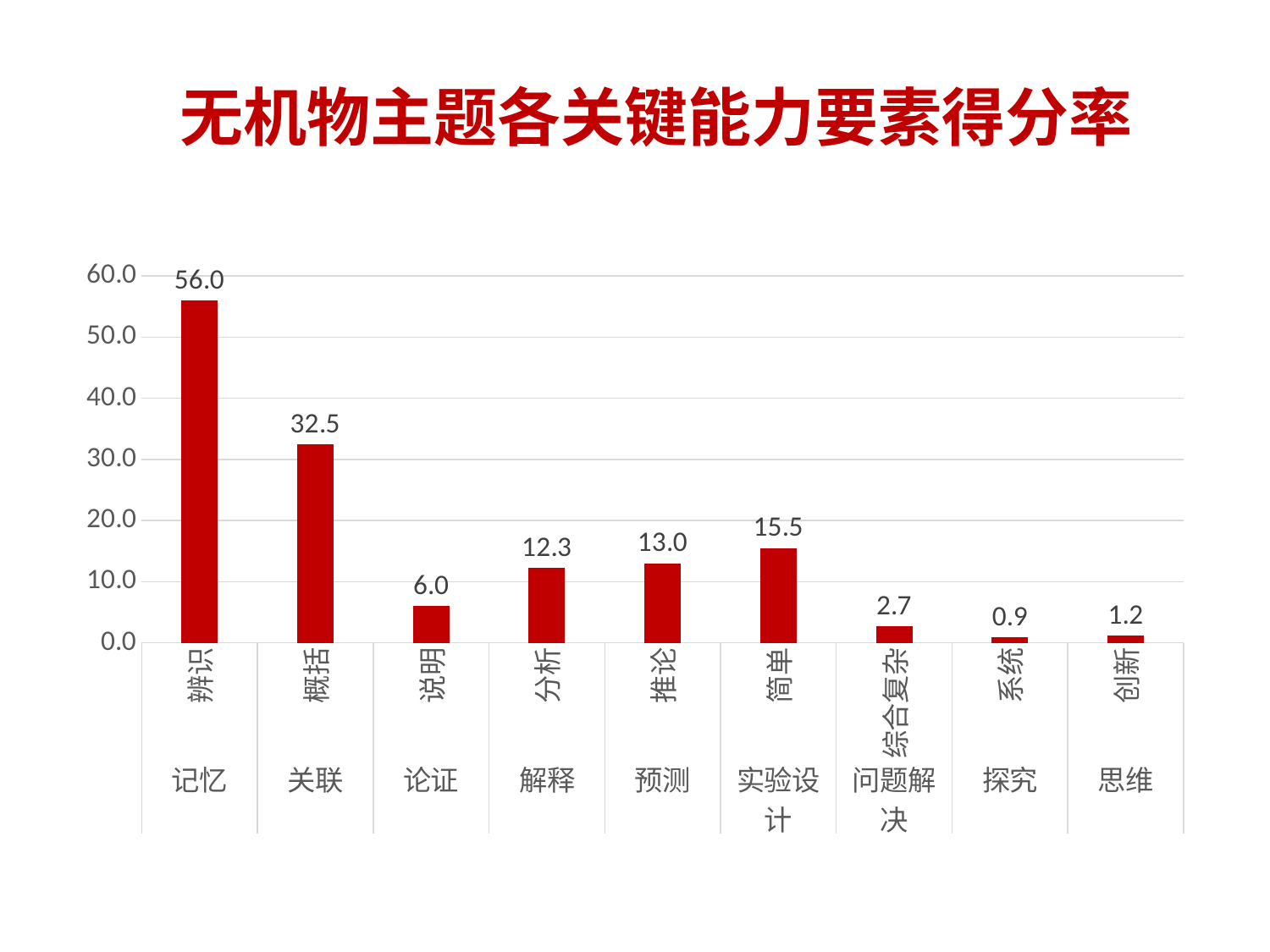
What is the value for 简单 (实验设计)? 15.5 What is the difference between the values for 辨识 and 概括? 23.5 Which is larger, the value for 分析 (解释) or the value for 推论 (预测)? 推论 (预测) What is the value for 概括 (关联)? 32.5 What kind of chart is shown on the slide? bar chart Which category has the highest value? 辨识 (记忆) What is the title of the chart? 无机物主题各关键能力要素得分率 Which category has the lowest value? 系统 (探究) What is the value for 辨识 (记忆)? 56.0 How many categories are shown on the x axis? 9 What is the value for 系统 (探究)? 0.9 What is the difference between the values for 创新 (思维) and 系统 (探究)? 0.3